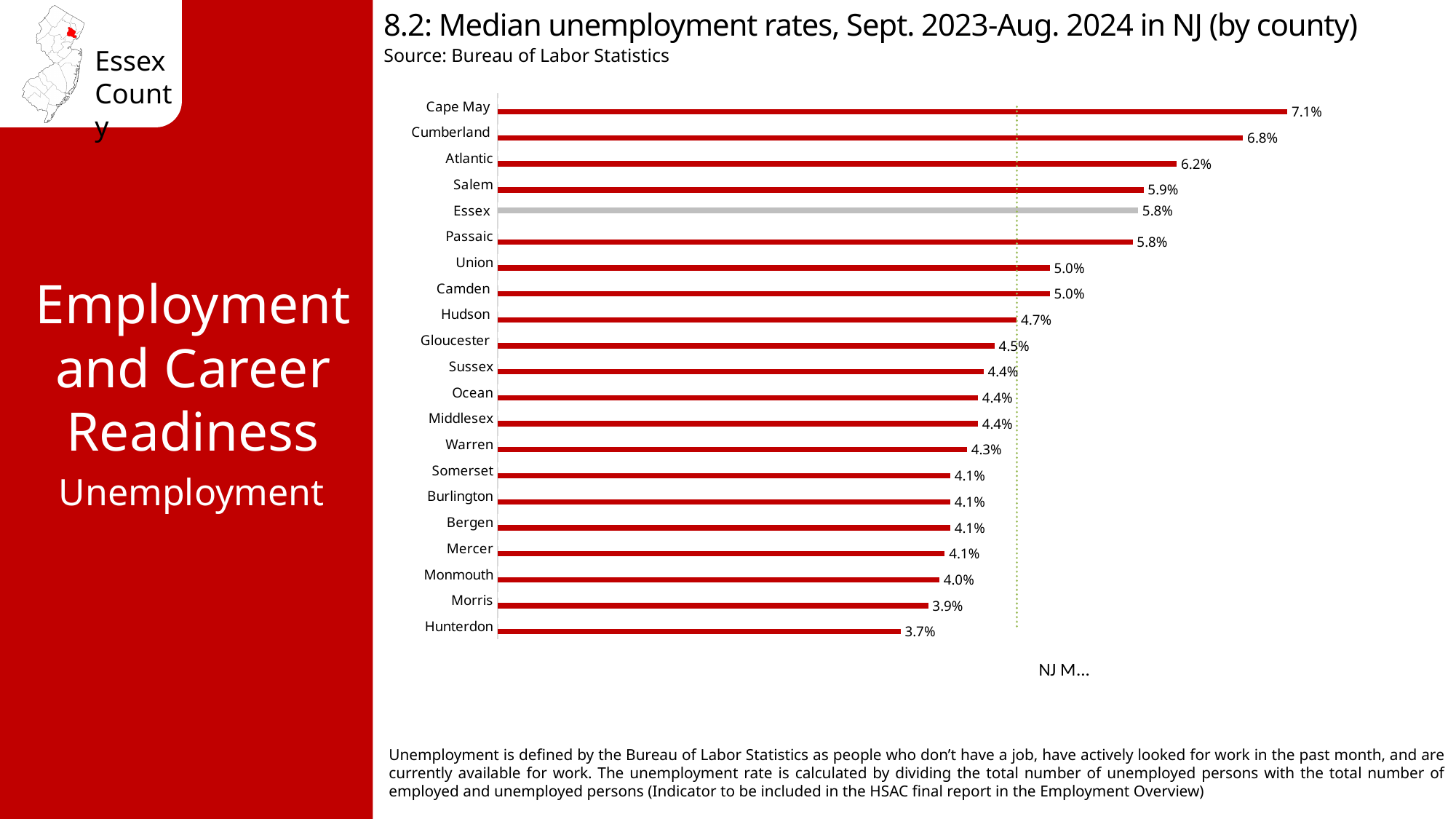
What is the median unemployment rate shown for Cape May? 7.1% Which county has a higher median unemployment rate, Salem or Union? Salem What is the difference between the median unemployment rates of Cumberland and Atlantic? 0.6% What type of chart is used to show the median unemployment rates by county? Bar chart What is the median unemployment rate shown for Essex county? 5.8% Which county has a higher median unemployment rate, Gloucester or Morris? Gloucester Which county has the lowest median unemployment rate on the chart? Hunterdon Which county's bar is coloured grey instead of red? Essex Which county has the highest median unemployment rate on the chart? Cape May What is the median unemployment rate shown for Hudson? 4.7% What is the difference between the median unemployment rates of Cape May and Hunterdon? 3.4% How many counties are shown on the chart? 21